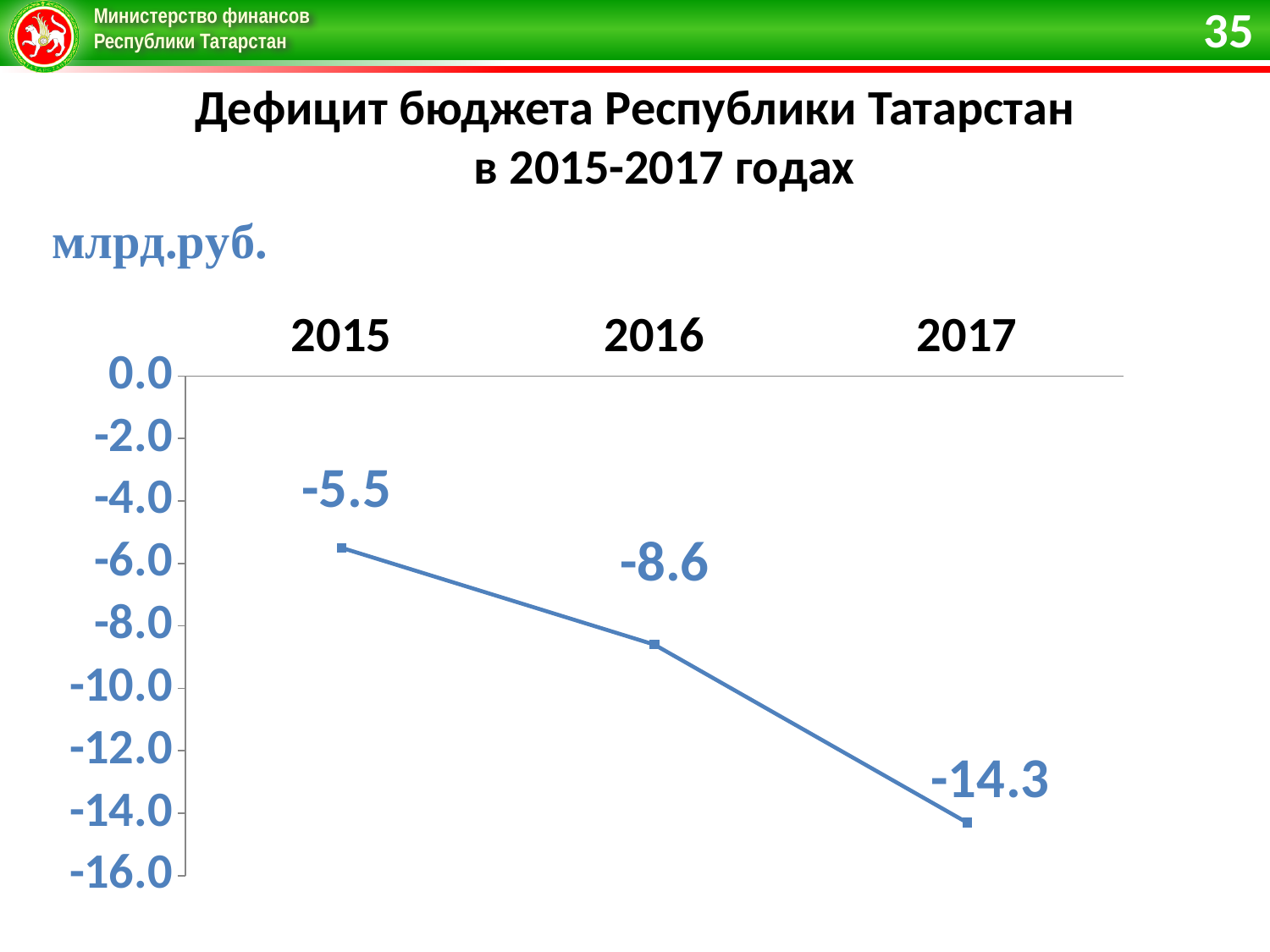
How many years are plotted on the chart? 3 What is the difference between the 2017 value and the 2015 value? 8.8 What is the budget deficit value for 2017? -14.3 What is the budget deficit value for 2016? -8.6 What is the budget deficit value for 2015? -5.5 Do the values rise or fall from 2015 to 2017? fall Is the value for 2017 greater or less than -12.0? less Which is larger, the value for 2015 or the value for 2016? 2015 What kind of chart is shown on the slide? line chart Which year has the highest (least negative) value on the chart? 2015 Which year has the lowest (most negative) value on the chart? 2017 What is the difference between the 2016 value and the 2015 value? 3.1